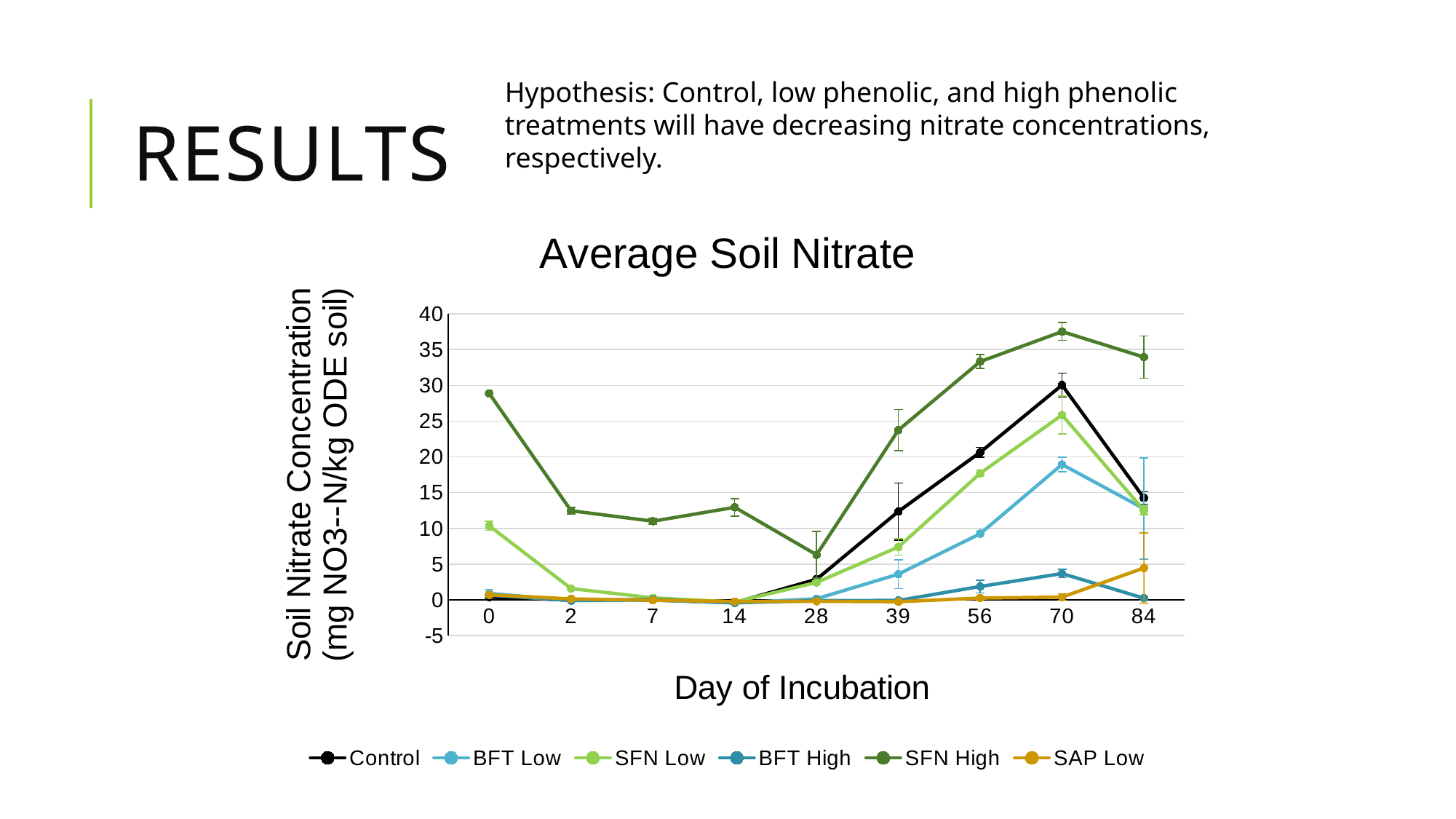
Is the value for SFN Low at day 0 greater or less than 5? greater At day 84, which is larger: the SFN High value or the Control value? SFN High What kind of chart is shown on the slide? line chart Is the value for SFN High at day 0 greater or less than 25? greater Which series has the lowest soil nitrate concentration at day 70? SAP Low At day 56, which is larger: the Control value or the BFT Low value? Control Is the value for SFN High at day 70 greater or less than 35? greater How many series does the legend of the Average Soil Nitrate chart list? 6 Does the SFN High series rise or fall between day 0 and day 2? fall How many days of incubation are plotted along the x axis of the chart? 9 Which series has the highest soil nitrate concentration at day 70? SFN High What is the title of the chart? Average Soil Nitrate